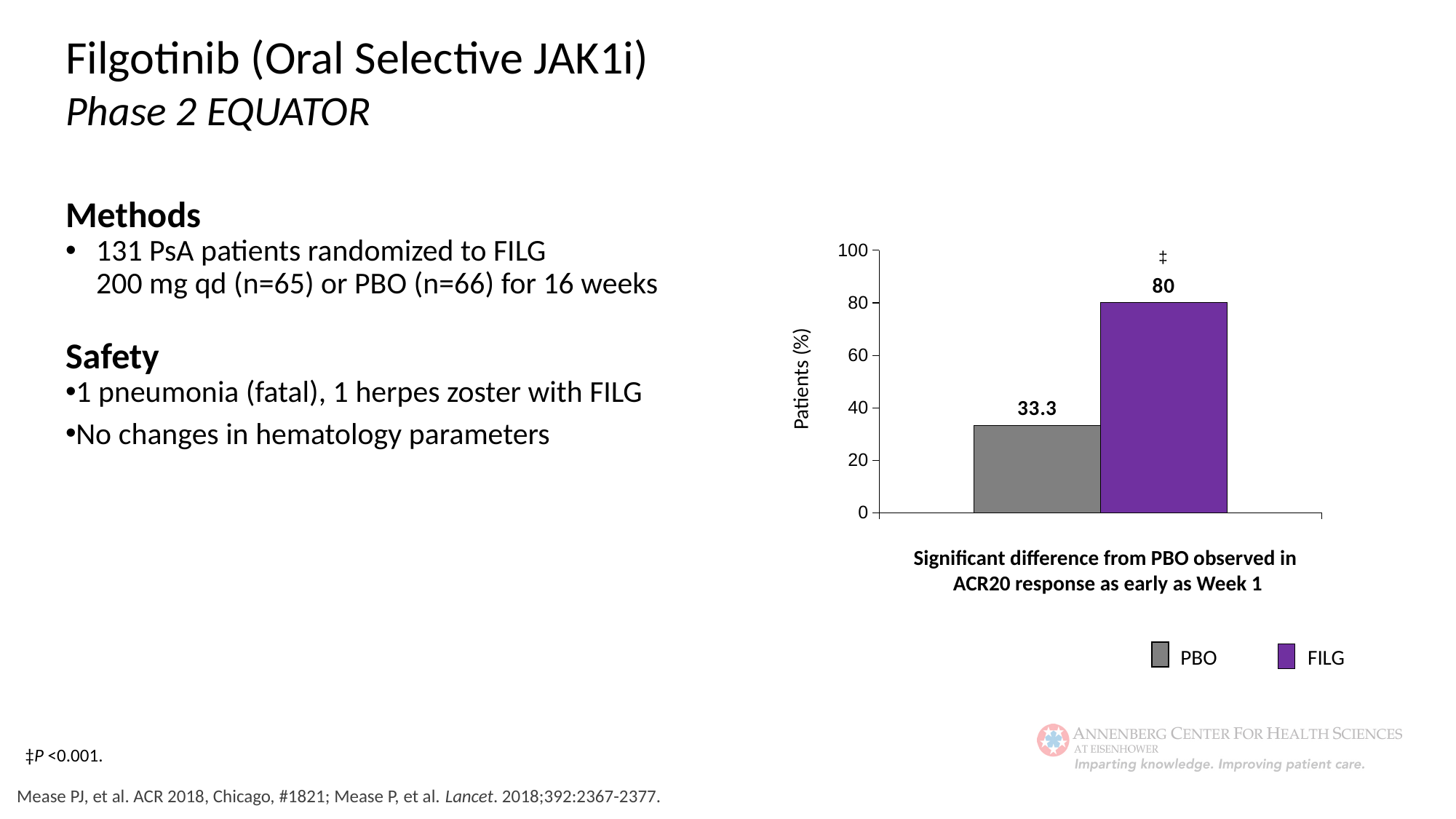
What is the difference between the FILG and PBO values? 46.7 How many series does the legend list? 2 How many bars are plotted in the chart? 2 What kind of chart is shown on the slide? bar chart Which group has the highest value in the chart? FILG Is the value for PBO greater or less than 40? less Which group has the higher value, PBO or FILG? FILG What is the value for FILG in the chart? 80 Which group has the lowest value in the chart? PBO Is the value for FILG greater or less than 60? greater What is the label of the y axis of the chart? Patients (%) What is the value for PBO in the chart? 33.3